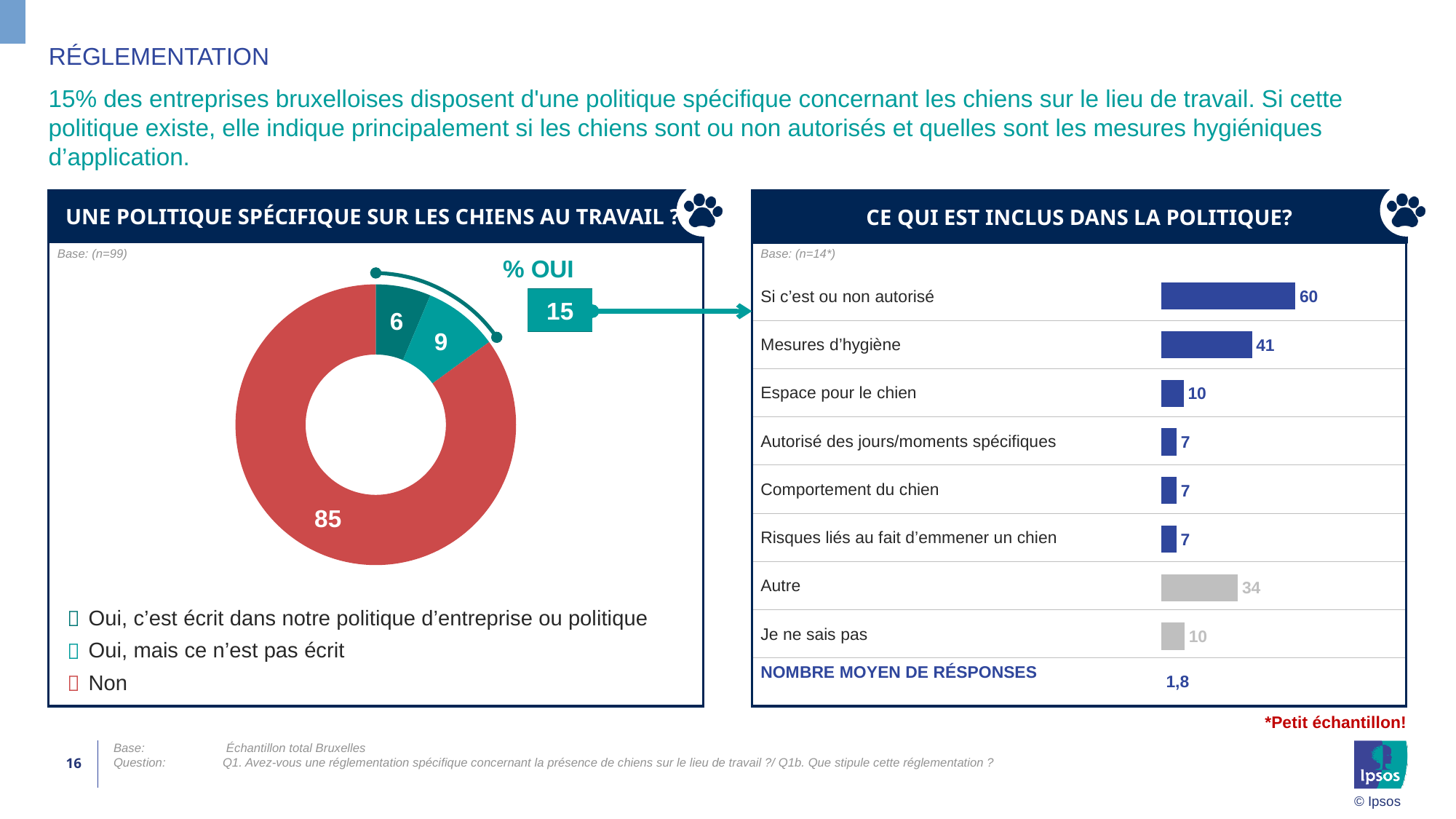
In the chart titled "CE QUI EST INCLUS DANS LA POLITIQUE?", how many categories are plotted? 8 In the chart titled "CE QUI EST INCLUS DANS LA POLITIQUE?", what value is shown for "Mesures d'hygiène"? 41 In the chart titled "UNE POLITIQUE SPÉCIFIQUE SUR LES CHIENS AU TRAVAIL ?", what value is shown for "Non"? 85 In the chart titled "UNE POLITIQUE SPÉCIFIQUE SUR LES CHIENS AU TRAVAIL ?", what is the combined "% OUI" value shown? 15 In the chart titled "CE QUI EST INCLUS DANS LA POLITIQUE?", which category has the highest value? Si c'est ou non autorisé In the chart titled "CE QUI EST INCLUS DANS LA POLITIQUE?", what is the difference between "Si c'est ou non autorisé" and "Mesures d'hygiène"? 19 What kind of chart is the one titled "UNE POLITIQUE SPÉCIFIQUE SUR LES CHIENS AU TRAVAIL ?"? Donut (pie) chart In the chart titled "UNE POLITIQUE SPÉCIFIQUE SUR LES CHIENS AU TRAVAIL ?", how many categories does the legend list? 3 In the chart titled "CE QUI EST INCLUS DANS LA POLITIQUE?", which is larger: "Autre" or "Espace pour le chien"? Autre In the chart titled "UNE POLITIQUE SPÉCIFIQUE SUR LES CHIENS AU TRAVAIL ?", what value is shown for "Oui, c'est écrit dans notre politique d'entreprise ou politique"? 6 In the chart titled "UNE POLITIQUE SPÉCIFIQUE SUR LES CHIENS AU TRAVAIL ?", what value is shown for "Oui, mais ce n'est pas écrit"? 9 What kind of chart is the one titled "CE QUI EST INCLUS DANS LA POLITIQUE?"? Bar chart